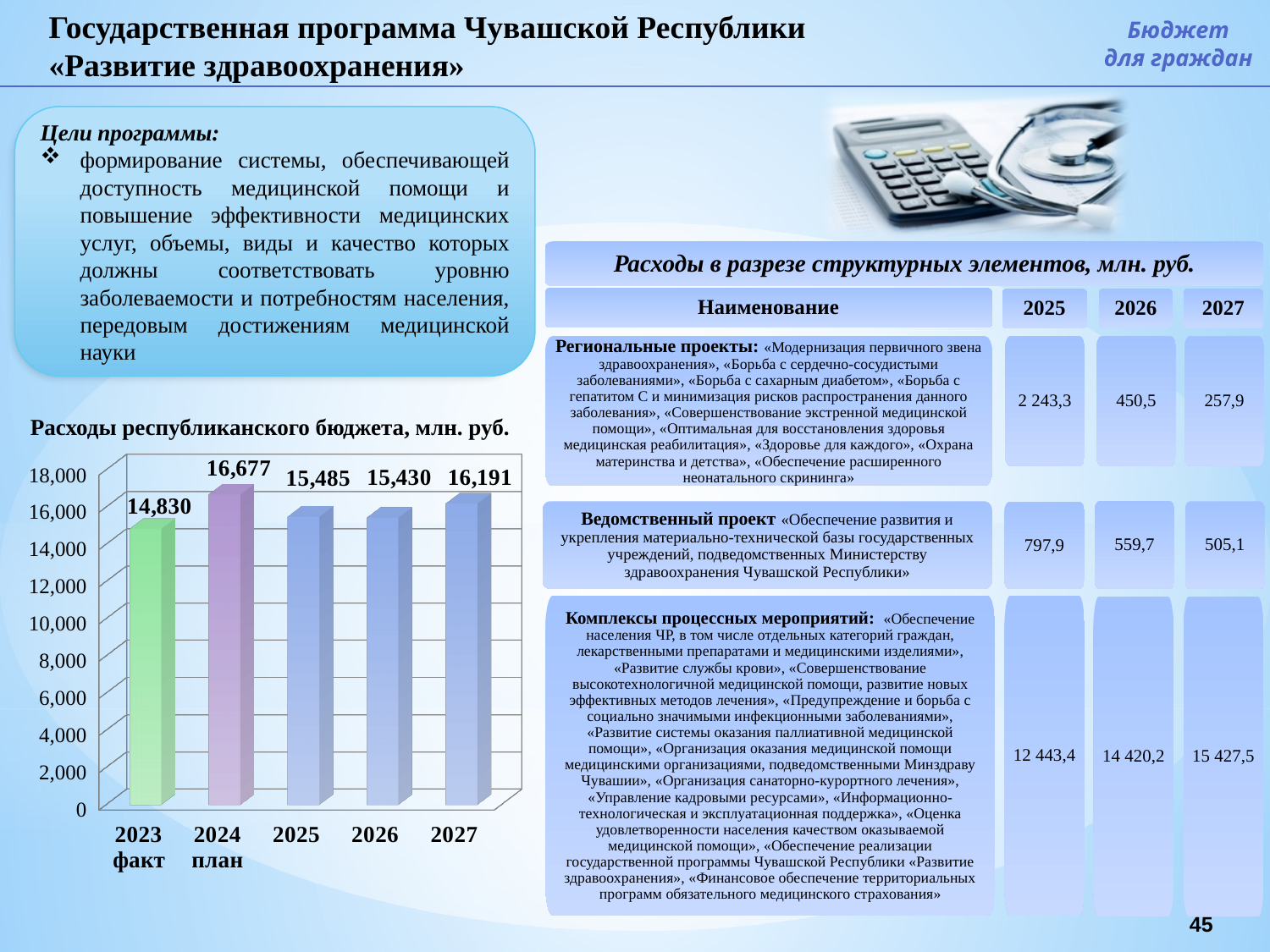
What kind of chart is 'Расходы республиканского бюджета, млн. руб.'? bar chart What is the value for 2027 in the chart 'Расходы республиканского бюджета, млн. руб.'? 16,191 In the chart 'Расходы республиканского бюджета, млн. руб.', does the value rise or fall from 2023 факт to 2024 план? rise Which year has the lowest value in the chart 'Расходы республиканского бюджета, млн. руб.'? 2023 факт In the chart 'Расходы республиканского бюджета, млн. руб.', is the value for 2023 факт greater or less than 14,000? greater How many bars are shown in the chart 'Расходы республиканского бюджета, млн. руб.'? 5 What is the difference between the 2024 план value and the 2023 факт value in the chart 'Расходы республиканского бюджета, млн. руб.'? 1,847 What is the value for 2024 план in the chart 'Расходы республиканского бюджета, млн. руб.'? 16,677 In the chart 'Расходы республиканского бюджета, млн. руб.', which is larger: the value for 2024 план or the value for 2027? 2024 план Which year has the highest value in the chart 'Расходы республиканского бюджета, млн. руб.'? 2024 план What is the value for 2023 факт in the chart 'Расходы республиканского бюджета, млн. руб.'? 14,830 What is the difference between the 2027 value and the 2026 value in the chart 'Расходы республиканского бюджета, млн. руб.'? 761